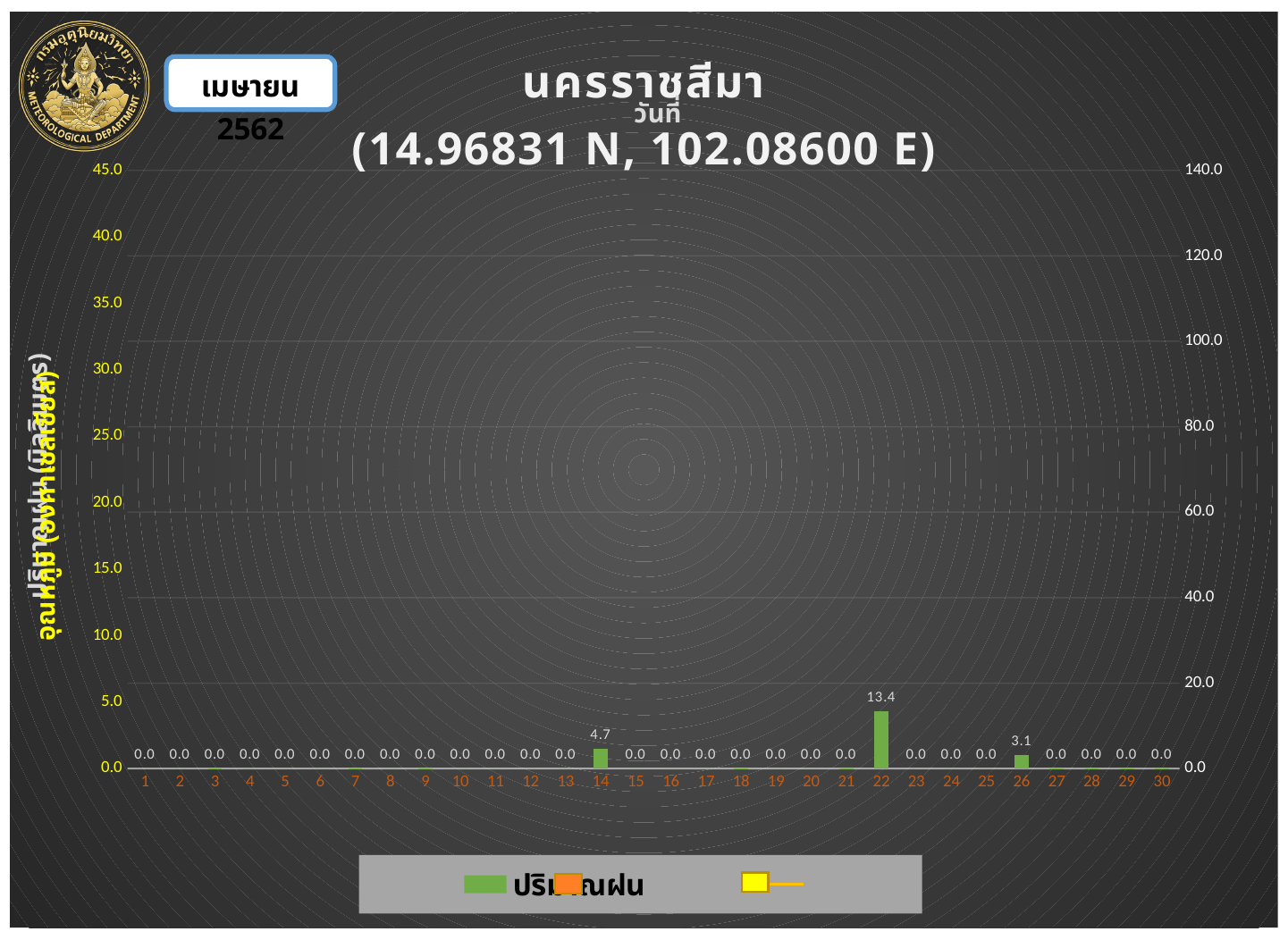
What is the rainfall value shown for day 26? 3.1 Which day has the highest rainfall value? 22 What is the difference between the rainfall values for day 22 and day 14? 8.7 What is the station name given in the chart title? นครราชสีมา How many days are shown on the x axis? 30 What is the difference between the rainfall values for day 14 and day 26? 1.6 What kind of chart is shown on the slide? bar chart What is the rainfall value shown for day 14? 4.7 What is the rainfall value shown for day 22? 13.4 Which is larger, the rainfall value for day 14 or for day 26? day 14 What is the rainfall value shown for day 10? 0.0